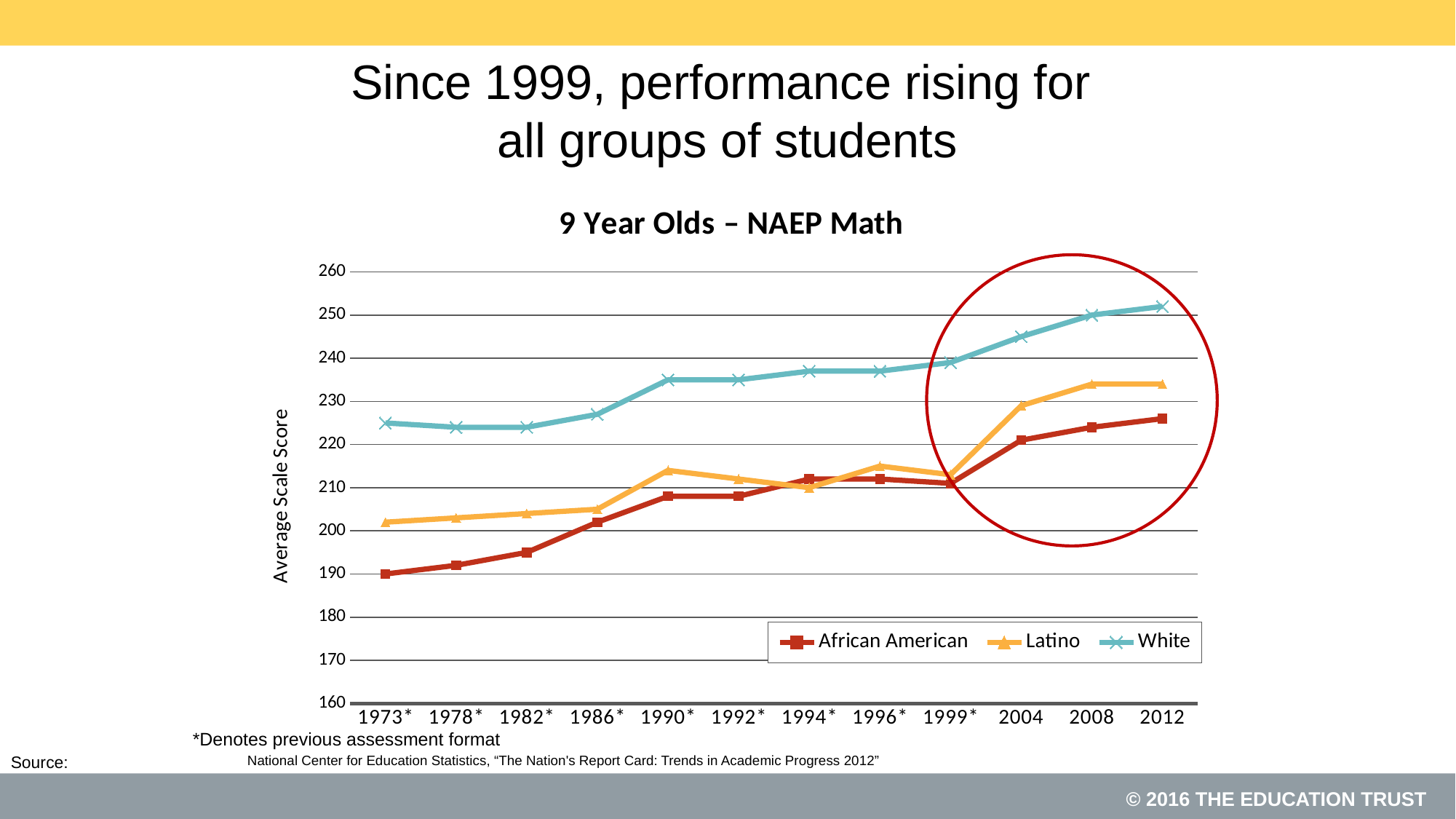
What is the title of the chart? 9 Year Olds – NAEP Math Is the value for White students in 2012 greater or less than 250? greater Is the value for African American students in 2012 greater or less than 230? less What type of chart is shown on the slide? line chart How many series does the legend list? 3 Does the average scale score for White students rise or fall from 1999* to 2012? rise What is the average scale score for White students in 2008? 250 Which group has the lowest average scale score in 1973*? African American What is the average scale score for African American students in 1973*? 190 How many assessment years are shown on the x axis? 12 In 2012, which group has the larger average scale score, Latino or African American? Latino Which group has the highest average scale score in 2012? White